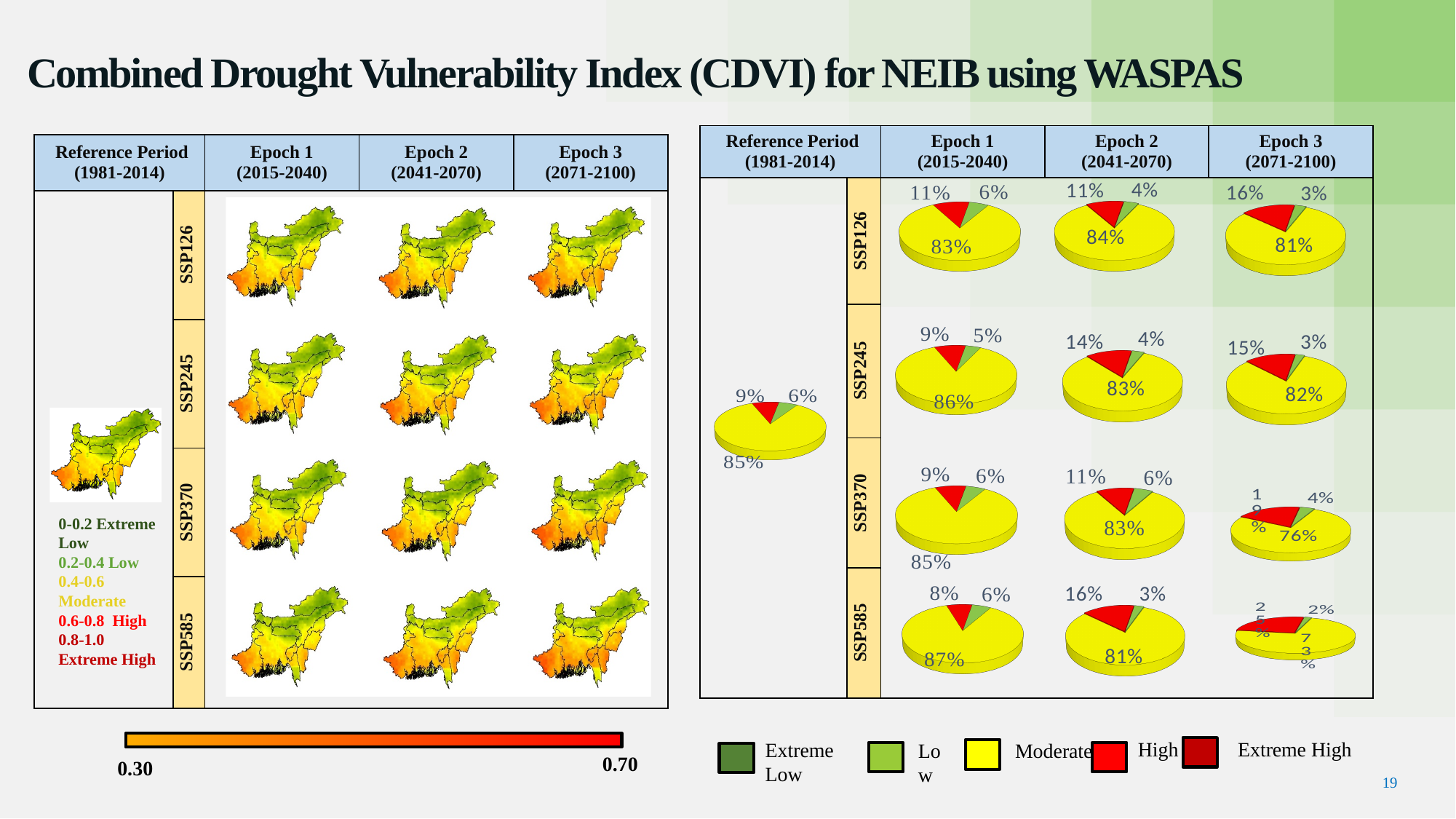
In the legend below the pie charts, which category is shown in yellow? Moderate In the SSP126 Epoch 3 (2071-2100) pie chart, what share is labelled for the High (red) slice? 16% In the SSP585 Epoch 1 (2015-2040) pie chart, what share is labelled for the Moderate (yellow) slice? 87% What kind of chart is used in the right-hand table to show the vulnerability class shares? Pie chart In the SSP245 Epoch 2 (2041-2070) pie chart, what share is labelled for the Low (green) slice? 4% In the SSP245 Epoch 3 (2071-2100) pie chart, what is the difference between the Moderate share and the High share? 67% In the Reference Period (1981-2014) pie chart, what share is labelled for the High (red) slice? 9% In the Reference Period (1981-2014) pie chart, what share is labelled for the Moderate (yellow) slice? 85% In the SSP126 Epoch 1 (2015-2040) pie chart, which category has the smallest slice? Low In the SSP370 Epoch 2 (2041-2070) pie chart, which category has the largest slice? Moderate Is the High (red) share larger in the SSP585 Epoch 2 (2041-2070) pie chart or in the SSP585 Epoch 1 (2015-2040) pie chart? SSP585 Epoch 2 (2041-2070) How many categories does the legend below the pie charts list? 5